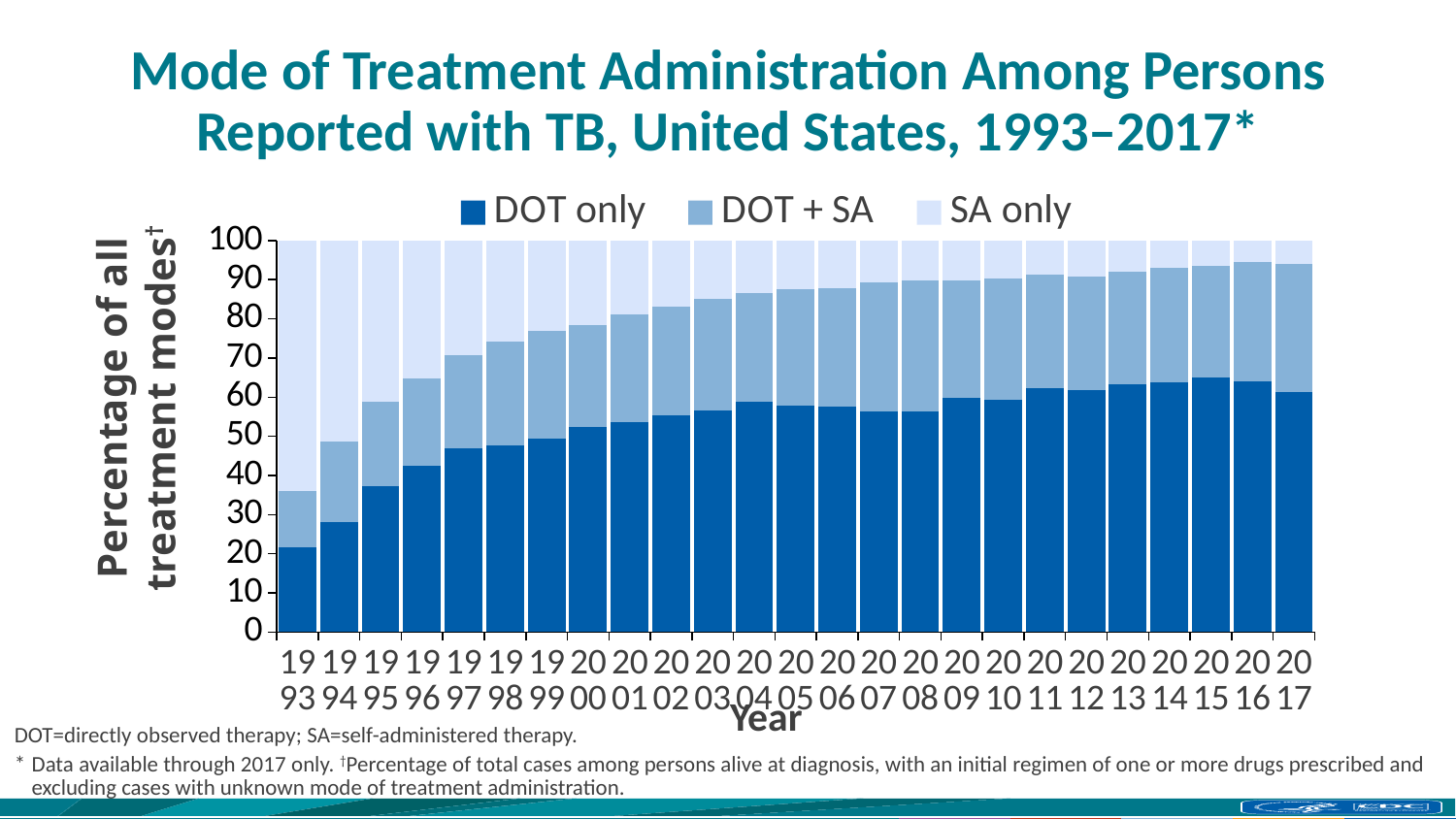
What is the label of the y axis? Percentage of all treatment modes Is the DOT only value for 2017 greater or less than 50? greater Is the DOT only value for 1993 greater or less than 30? less Which year has the lowest DOT only percentage? 1993 How many series does the legend list? 3 What kind of chart is shown on the slide? Stacked bar chart Is the DOT only value for 1996 greater or less than 50? less Does the DOT only percentage generally rise or fall from 1993 to 2017? Rise Which year has the larger DOT only percentage, 1993 or 2017? 2017 Which year has the larger SA only percentage, 1993 or 2017? 1993 How many years (bars) are plotted on the chart? 25